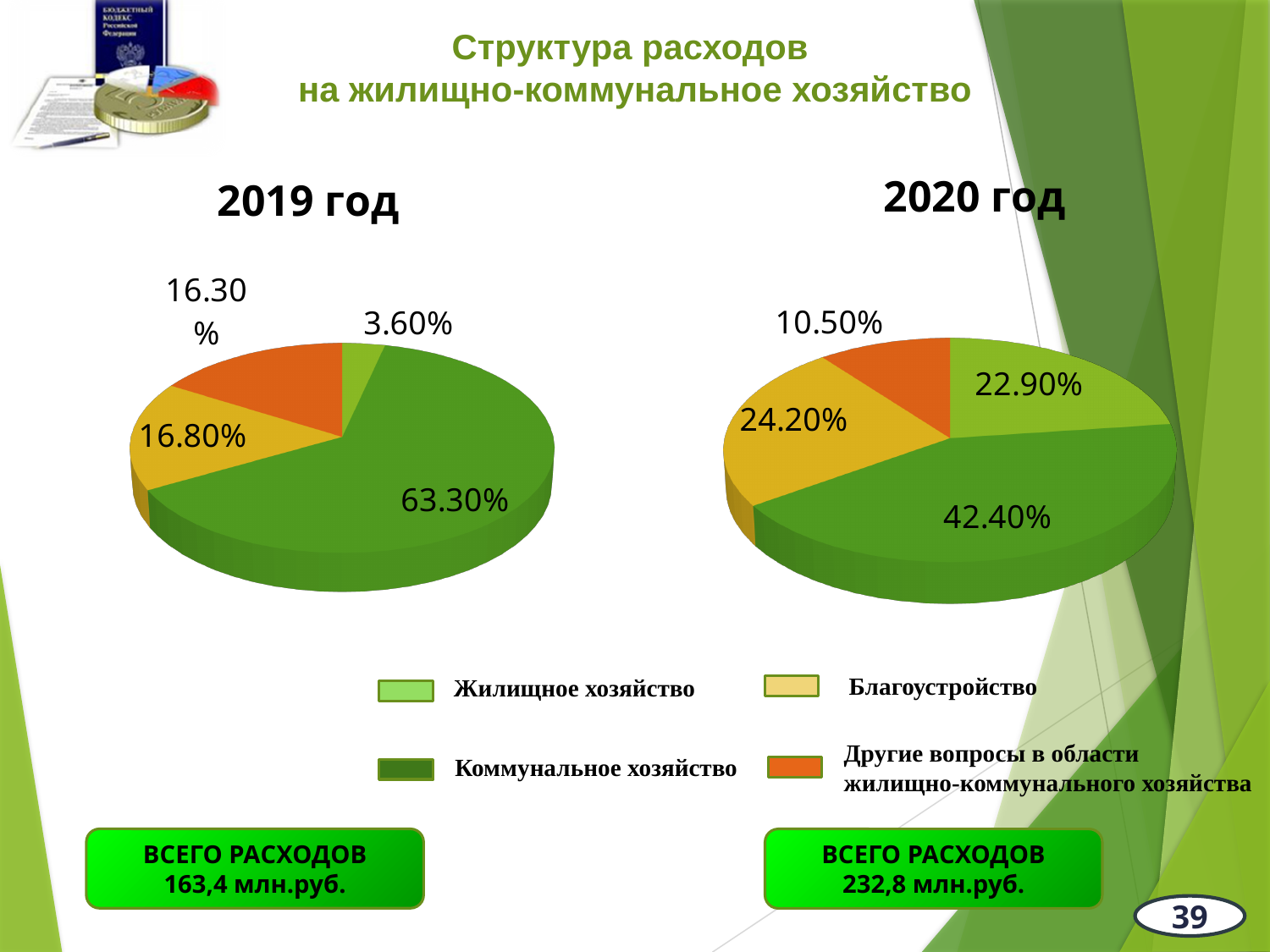
Which colour represents Благоустройство in the legend? Yellow In the 2019 год pie chart, what share is shown for Коммунальное хозяйство? 63.30% In the 2020 год pie chart, what share is shown for Благоустройство? 24.20% In the 2020 год pie chart, what share is shown for Другие вопросы в области жилищно-коммунального хозяйства? 10.50% In the 2020 год pie chart, which category has the largest share? Коммунальное хозяйство How many slices does the 2020 год pie chart have? 4 What type of chart is used to show the 2019 год data? Pie chart In the 2020 год pie chart, which category has the smallest share? Другие вопросы в области жилищно-коммунального хозяйства In the 2019 год pie chart, which category has the smallest share? Жилищное хозяйство In the 2019 год pie chart, which is larger: the share for Благоустройство or the share for Другие вопросы в области жилищно-коммунального хозяйства? Благоустройство In the 2019 год pie chart, what share is shown for Жилищное хозяйство? 3.60% What is the difference in percentage points between the Коммунальное хозяйство share in 2019 год and in 2020 год? 20.90